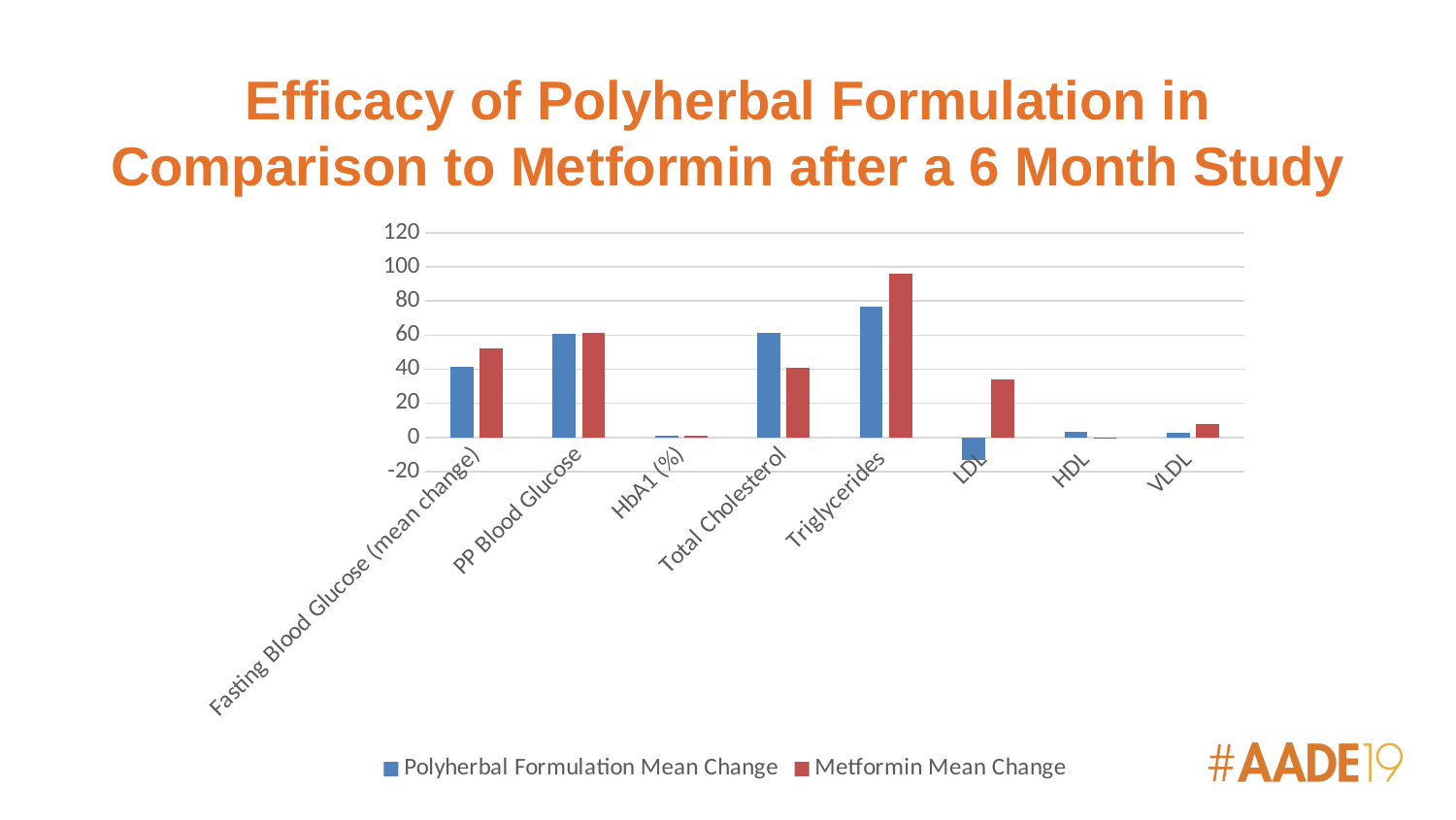
Is the Polyherbal Formulation Mean Change value for LDL greater or less than 0? less For Fasting Blood Glucose (mean change), which series has the larger value: Polyherbal Formulation Mean Change or Metformin Mean Change? Metformin Mean Change Which category has the highest Metformin Mean Change value? Triglycerides What kind of chart is shown on the slide? bar chart How many series does the legend list? 2 Which category has the lowest Polyherbal Formulation Mean Change value? LDL Is the Metformin Mean Change value for LDL greater or less than 20? greater What colour are the bars for the Metformin Mean Change series? red For Total Cholesterol, which series has the larger value: Polyherbal Formulation Mean Change or Metformin Mean Change? Polyherbal Formulation Mean Change Is the Metformin Mean Change value for Triglycerides greater or less than 80? greater How many categories are shown on the x axis? 8 Which category has the highest Polyherbal Formulation Mean Change value? Triglycerides